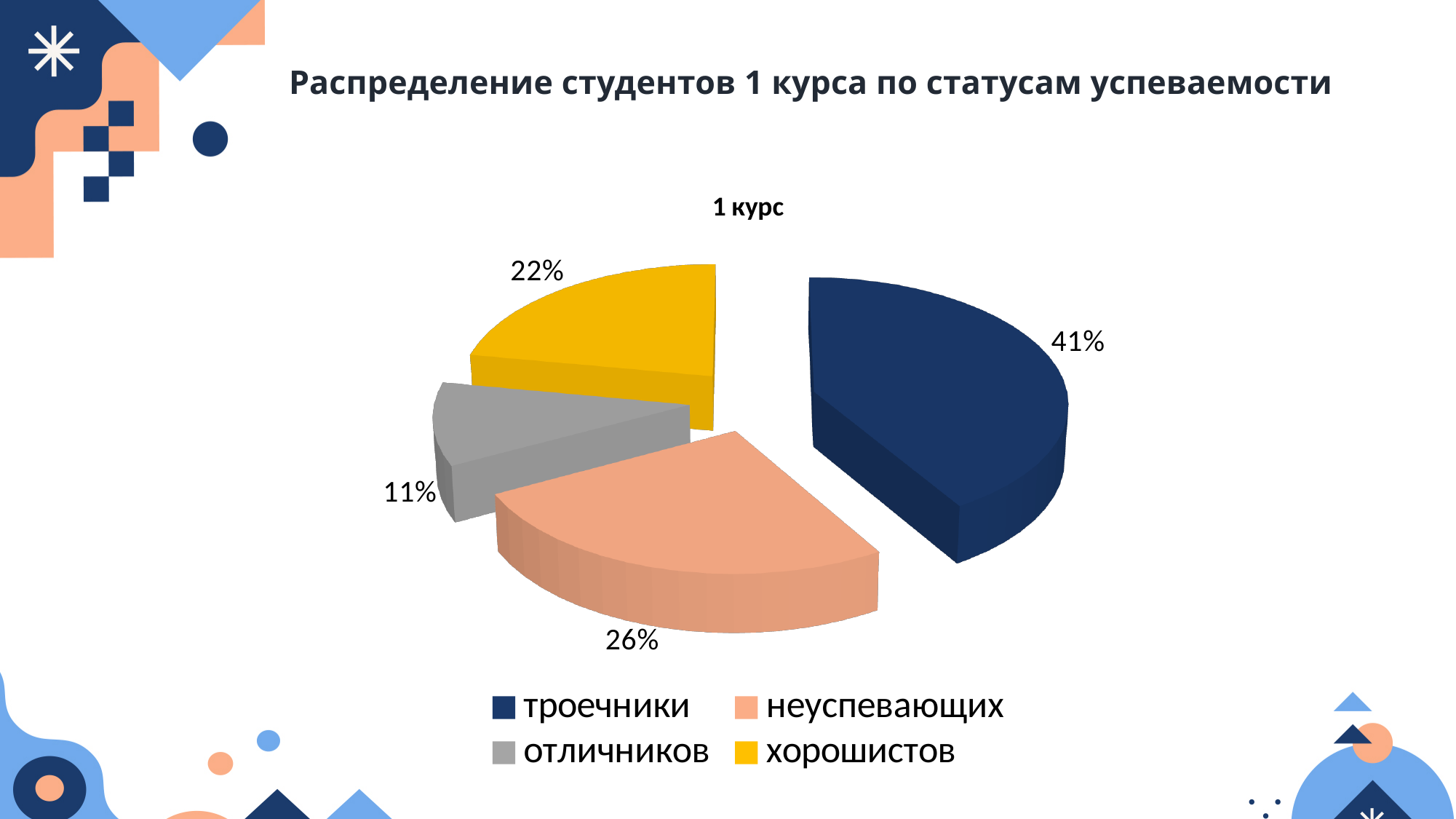
What percentage of the pie chart is the slice for хорошистов? 22% What percentage of the pie chart is the slice for неуспевающих? 26% What percentage of the pie chart is the slice for отличников? 11% Which slice is larger: неуспевающих or хорошистов? неуспевающих What colour is the slice for хорошистов in the pie chart? yellow What is the title shown directly above the pie chart? 1 курс How many slices does the pie chart have? 4 What type of chart is shown on the slide? pie chart What percentage of the pie chart is the slice for троечники? 41% Which category has the smallest share of the pie chart? отличников Which category has the largest share of the pie chart? троечники What is the difference in percentage points between the троечники slice and the хорошистов slice? 19